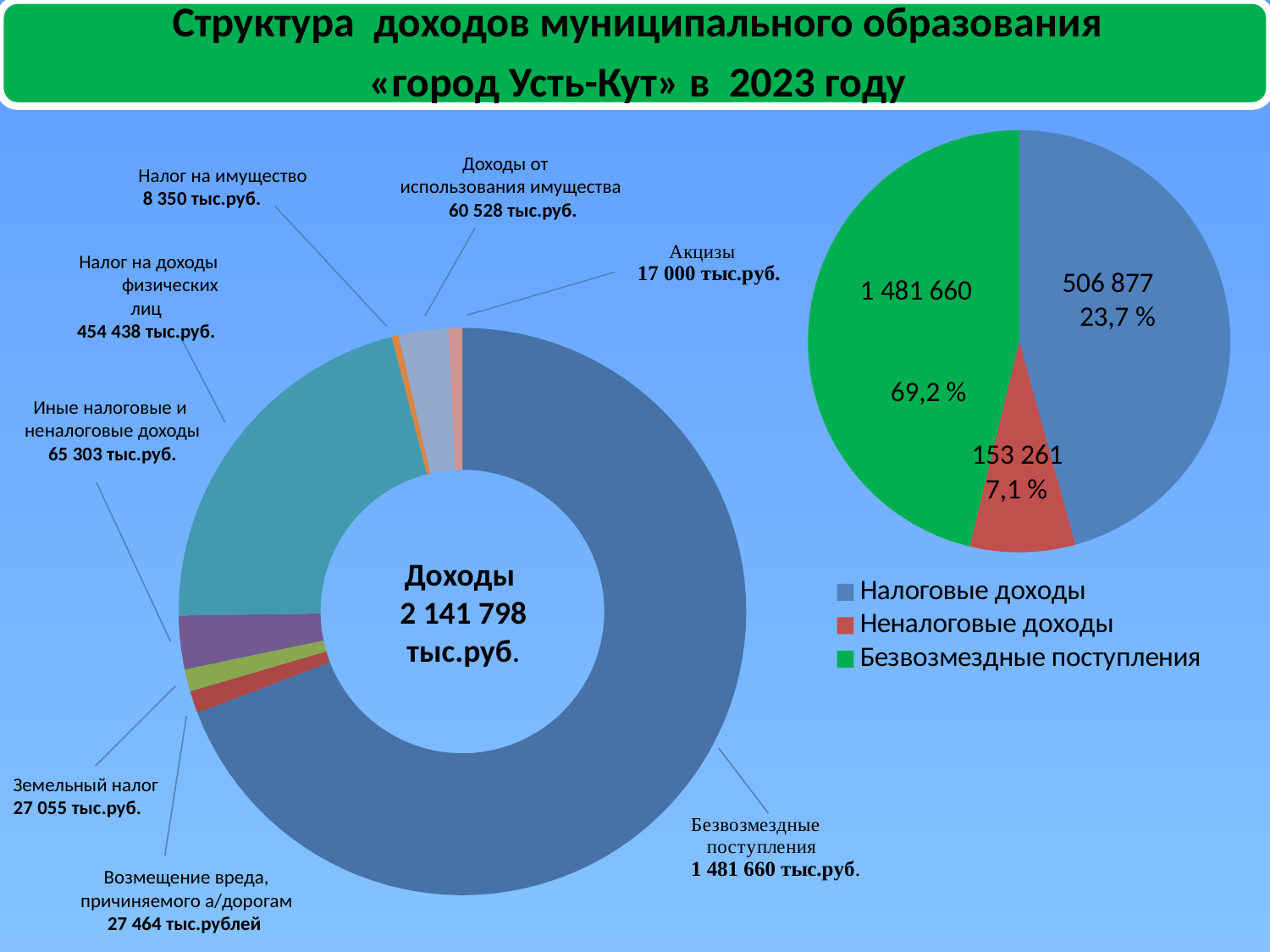
On the right pie chart, which category is the smallest? Неналоговые доходы How many entries does the legend of the right pie chart list? 3 What type of chart is shown on the right side of the slide? Pie chart On the right pie chart, what share of the total is Неналоговые доходы? 7,1 % What total is shown in the centre of the left doughnut chart? 2 141 798 тыс.руб. On the right pie chart, what is the value for Налоговые доходы? 506 877 On the right pie chart, which category is the largest? Безвозмездные поступления On the left doughnut chart, which is larger: Земельный налог or Возмещение вреда, причиняемого а/дорогам? Возмещение вреда, причиняемого а/дорогам On the left doughnut chart, what is the value for Акцизы? 17 000 тыс.руб. On the left doughnut chart, what is the value for Налог на доходы физических лиц? 454 438 тыс.руб. On the right pie chart, what is the difference between Налоговые доходы and Неналоговые доходы? 353 616 On the right pie chart, what share of the total is Безвозмездные поступления? 69,2 %